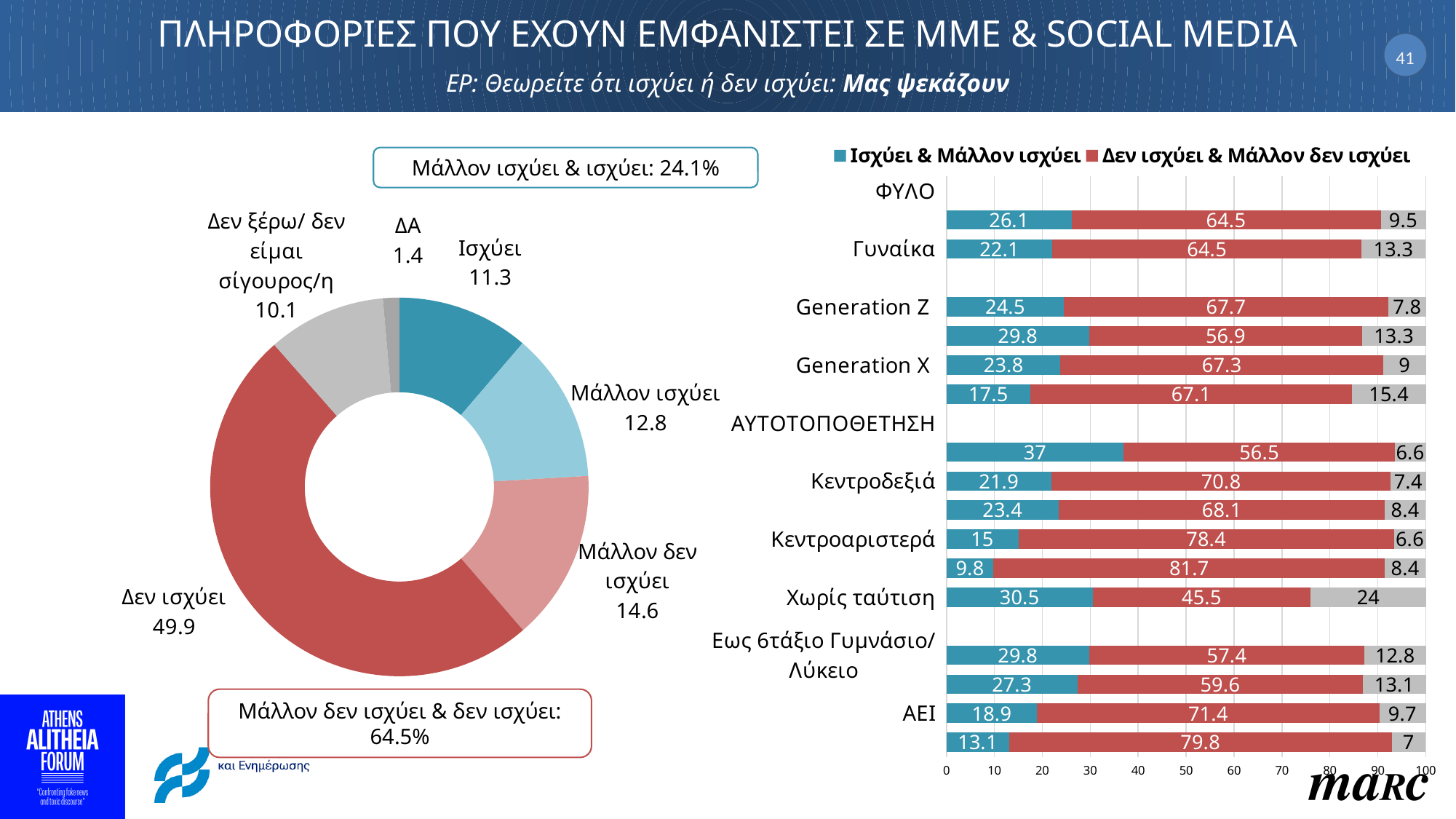
How many series does the legend of the bar chart on the right list? 2 In the donut chart on the left, which category has the smallest share? ΔΑ In the bar chart on the right, what is the value of the grey segment for Χωρίς ταύτιση? 24 In the donut chart on the left, what is the value for Δεν ισχύει? 49.9 How many categories are shown in the donut chart on the left? 6 In the donut chart on the left, what is the difference between Μάλλον δεν ισχύει and Μάλλον ισχύει? 1.8 In the donut chart on the left, which category has the largest share? Δεν ισχύει In the bar chart on the right, what is the value of Δεν ισχύει & Μάλλον δεν ισχύει for Κεντροαριστερά? 78.4 In the bar chart on the right, which has the higher Ισχύει & Μάλλον ισχύει value, Generation Z or Generation X? Generation Z What kind of chart is the chart on the right of the slide? Stacked bar chart In the bar chart on the right, what is the value of Ισχύει & Μάλλον ισχύει for Γυναίκα? 22.1 What kind of chart is the chart on the left of the slide? Donut (pie) chart